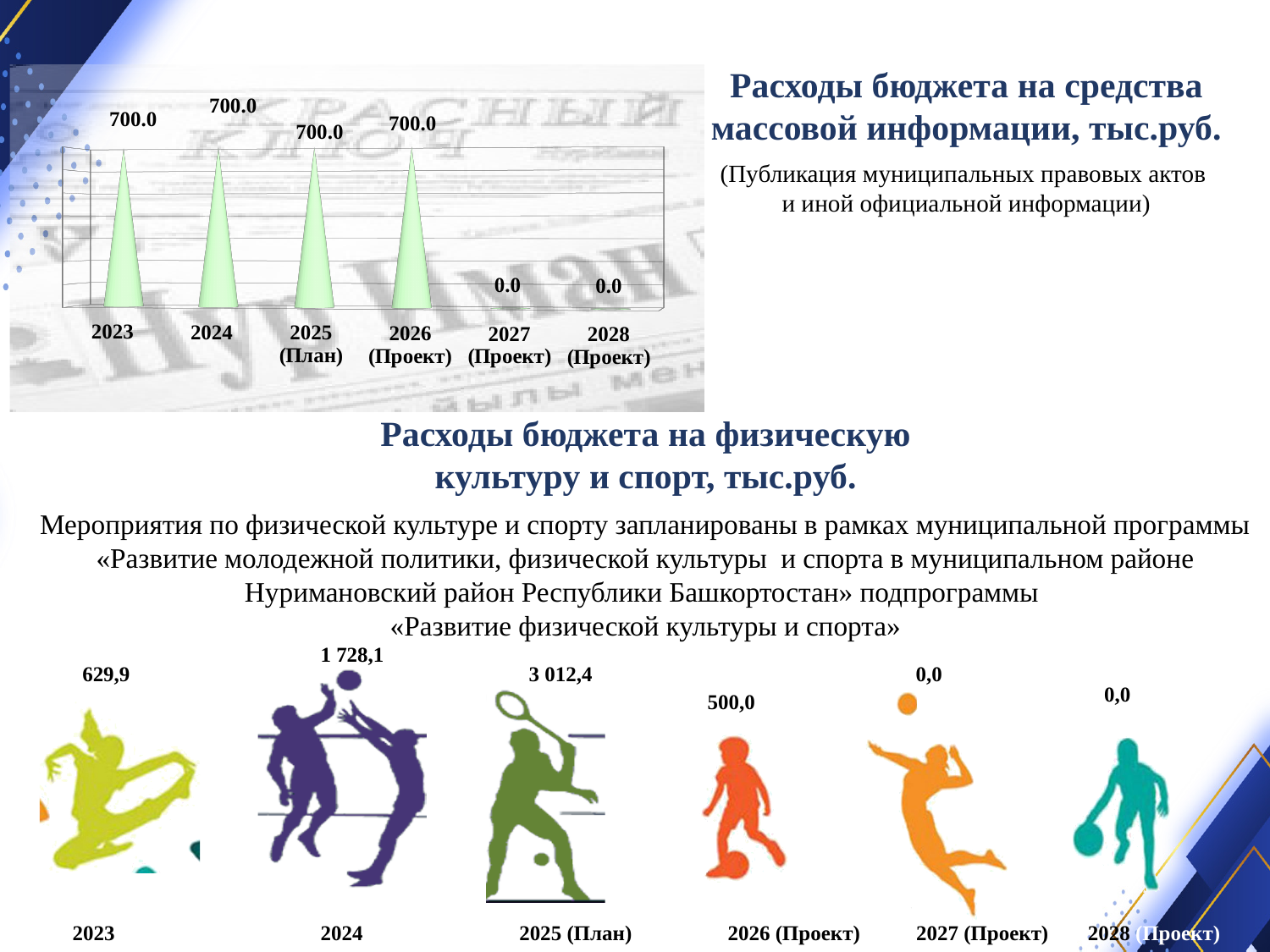
On the chart 'Расходы бюджета на физическую культуру и спорт, тыс.руб.', how many years are shown? 6 What kind of chart is 'Расходы бюджета на средства массовой информации, тыс.руб.'? bar chart On the chart 'Расходы бюджета на физическую культуру и спорт, тыс.руб.', what is the value for 2026 (Проект)? 500,0 On the chart 'Расходы бюджета на физическую культуру и спорт, тыс.руб.', what is the value for 2025 (План)? 3 012,4 On the chart 'Расходы бюджета на средства массовой информации, тыс.руб.', what is the difference between the values for 2026 (Проект) and 2027 (Проект)? 700.0 On the chart 'Расходы бюджета на средства массовой информации, тыс.руб.', what is the value for 2023? 700.0 On the chart 'Расходы бюджета на средства массовой информации, тыс.руб.', how many years are shown on the x axis? 6 On the chart 'Расходы бюджета на средства массовой информации, тыс.руб.', what is the value for 2027 (Проект)? 0.0 On the chart 'Расходы бюджета на физическую культуру и спорт, тыс.руб.', what is the value for 2024? 1 728,1 On the chart 'Расходы бюджета на физическую культуру и спорт, тыс.руб.', which is larger, the value for 2023 or the value for 2026 (Проект)? 2023 On the chart 'Расходы бюджета на физическую культуру и спорт, тыс.руб.', which year has the highest value? 2025 (План) On the chart 'Расходы бюджета на физическую культуру и спорт, тыс.руб.', what is the difference between the values for 2024 and 2023? 1 098,2